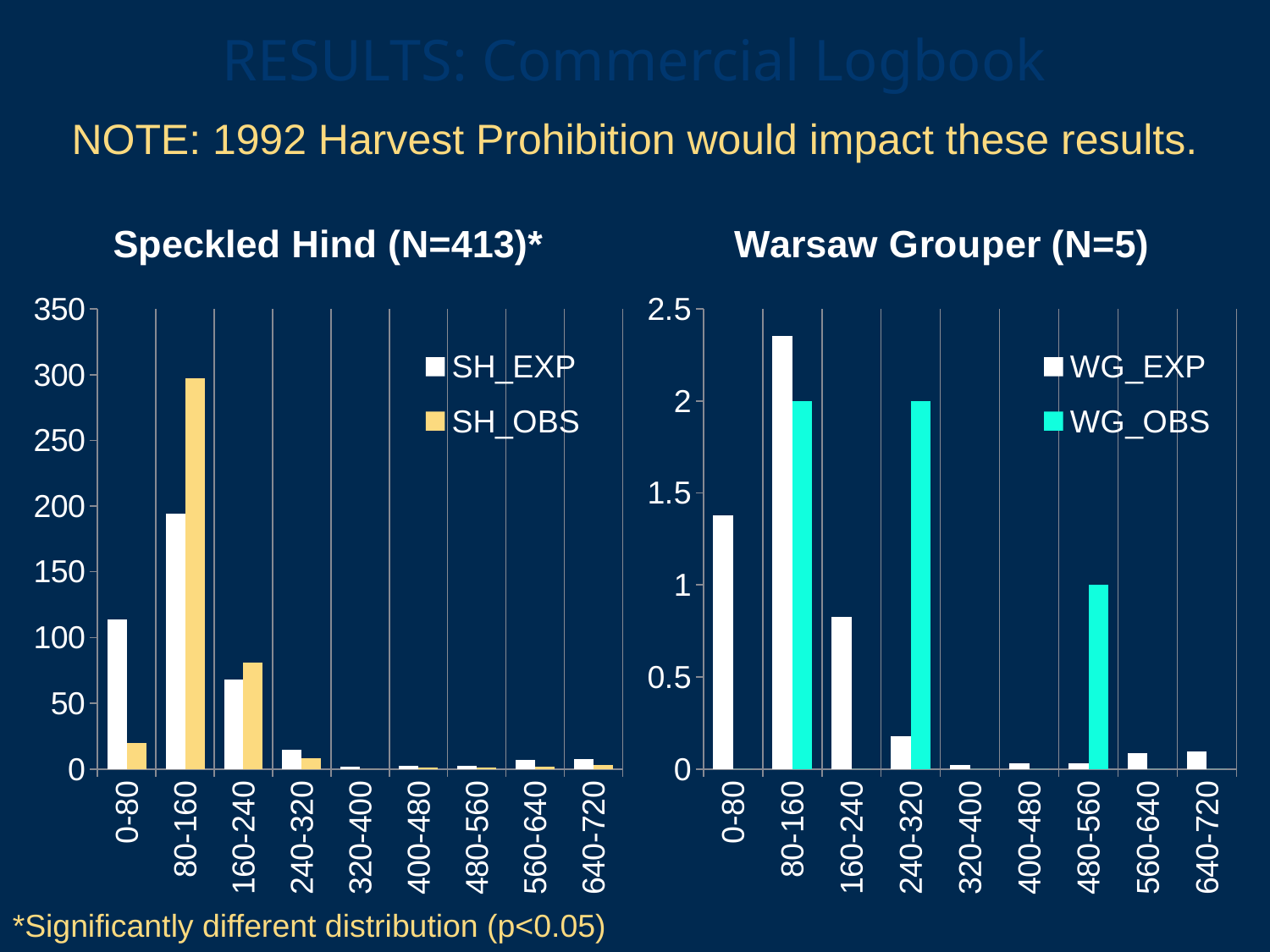
In the Warsaw Grouper (N=5) chart, which category has the highest WG_EXP value? 80-160 In the Speckled Hind (N=413)* chart, for the 0-80 category, which is larger: SH_EXP or SH_OBS? SH_EXP How many series does the legend of the Warsaw Grouper (N=5) chart list? 2 How many size categories are shown on the x axis of the Speckled Hind (N=413)* chart? 9 In the Warsaw Grouper (N=5) chart, what is the WG_OBS value for 80-160? 2 What kind of chart is the Speckled Hind (N=413)* chart? bar chart In the Speckled Hind (N=413)* chart, is the SH_OBS value for 80-160 greater or less than 250? greater In the Warsaw Grouper (N=5) chart, what is the WG_OBS value for 480-560? 1 In the Warsaw Grouper (N=5) chart, is the WG_EXP value for 0-80 greater or less than 1.5? less In the Warsaw Grouper (N=5) chart, what is the WG_OBS value for 240-320? 2 In the Speckled Hind (N=413)* chart, is the SH_EXP value for 0-80 greater or less than 100? greater In the Speckled Hind (N=413)* chart, which category has the highest SH_OBS value? 80-160